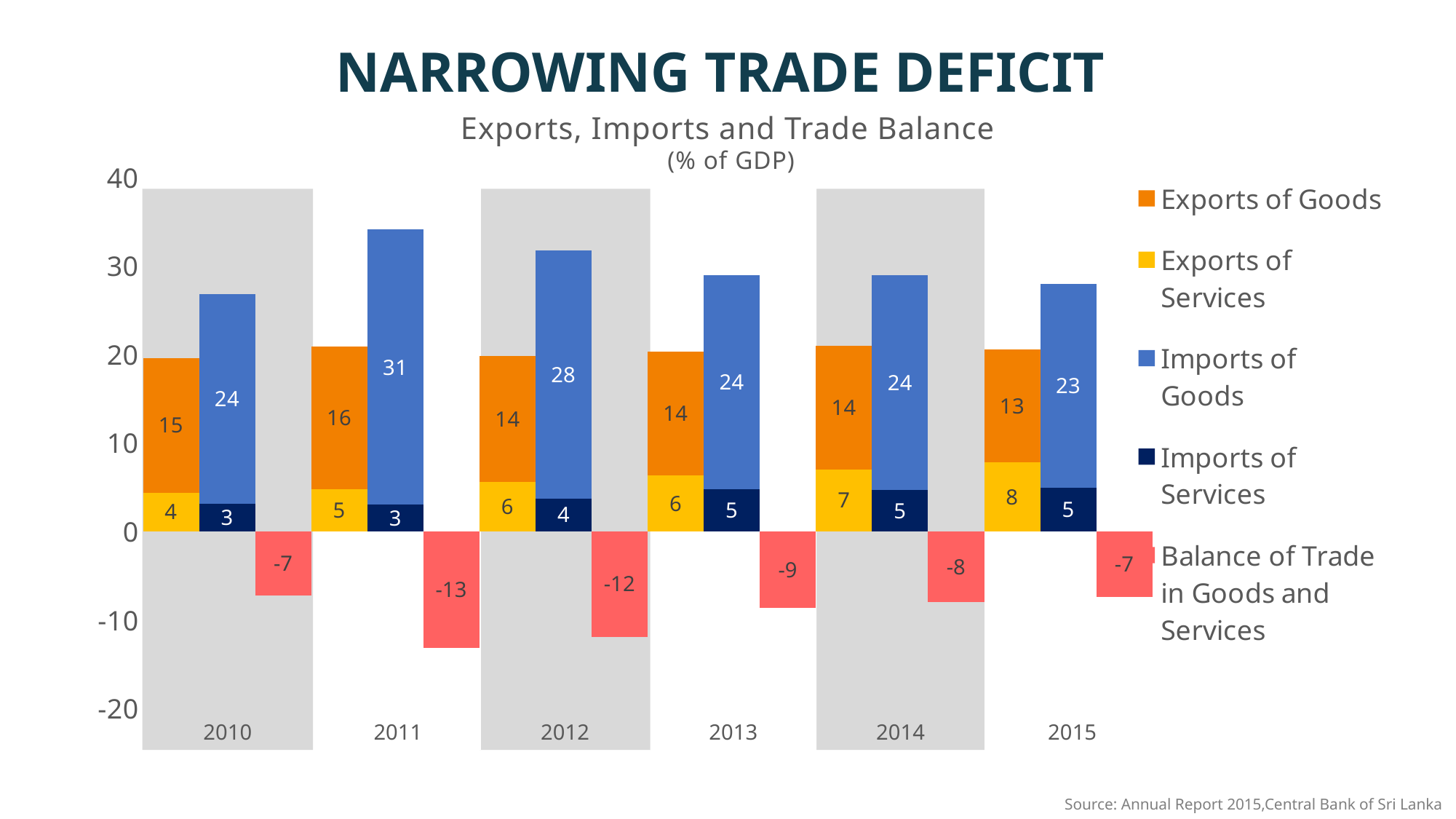
How many series does the legend list? 5 How many years are shown on the x axis? 6 What is the value for Imports of Goods in 2011? 31 In which year is Imports of Goods highest? 2011 What is the Balance of Trade in Goods and Services in 2013? -9 What is the total of the stacked imports bar (Imports of Goods plus Imports of Services) in 2015? 28 What is the difference between Imports of Goods and Exports of Goods in 2012? 14 What is the total of the stacked exports bar (Exports of Goods plus Exports of Services) in 2011? 21 What is the value for Exports of Services in 2015? 8 What kind of chart is shown on the slide? Bar chart In which year is the Balance of Trade in Goods and Services most negative? 2011 Which is larger in 2014: Exports of Services or Imports of Services? Exports of Services